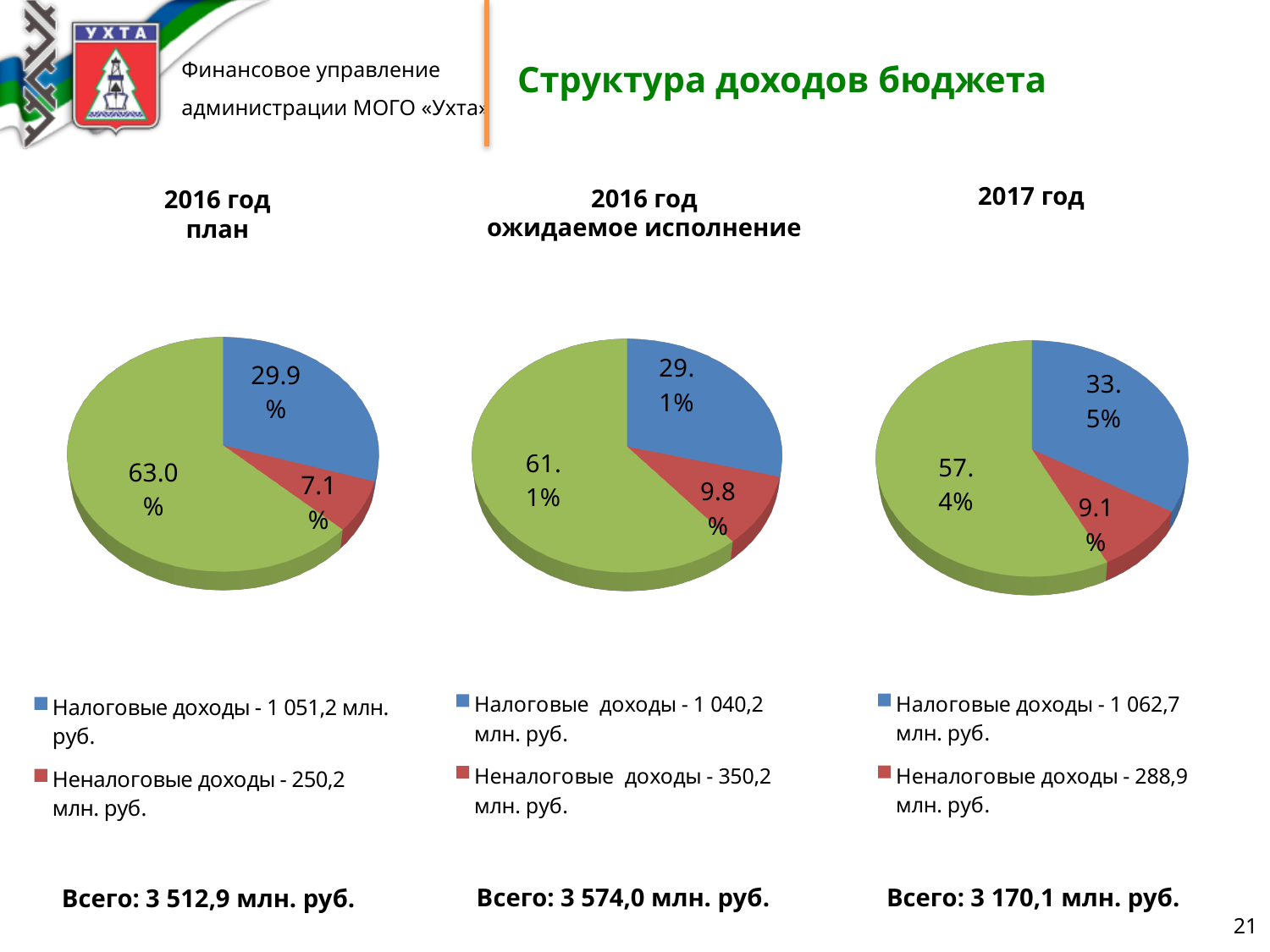
In the '2017 год' chart, what percentage is shown for the red slice (Неналоговые доходы)? 9.1% In the '2016 год план' chart, what percentage is shown for the blue slice (Налоговые доходы)? 29.9% In the '2016 год план' chart, what percentage is shown for the red slice (Неналоговые доходы)? 7.1% In the '2016 год ожидаемое исполнение' chart, which slice has the smallest share? the red slice (Неналоговые доходы), 9.8% How many entries does the legend under the '2017 год' chart list? 2 In the '2017 год' chart, what percentage is shown for the blue slice (Налоговые доходы)? 33.5% In the '2016 год план' chart, what is the difference in percentage points between the green slice and the blue slice? 33.1 percentage points In the '2016 год ожидаемое исполнение' chart, what percentage is shown for the green slice? 61.1% How many slices does the '2016 год ожидаемое исполнение' pie chart have? 3 What type of chart is used on this slide for the '2016 год план' chart? pie chart Which is larger: the blue slice in the '2017 год' chart or the blue slice in the '2016 год план' chart? the blue slice in the '2017 год' chart (33.5%) In the '2017 год' chart, which slice has the largest share? the green slice, 57.4%